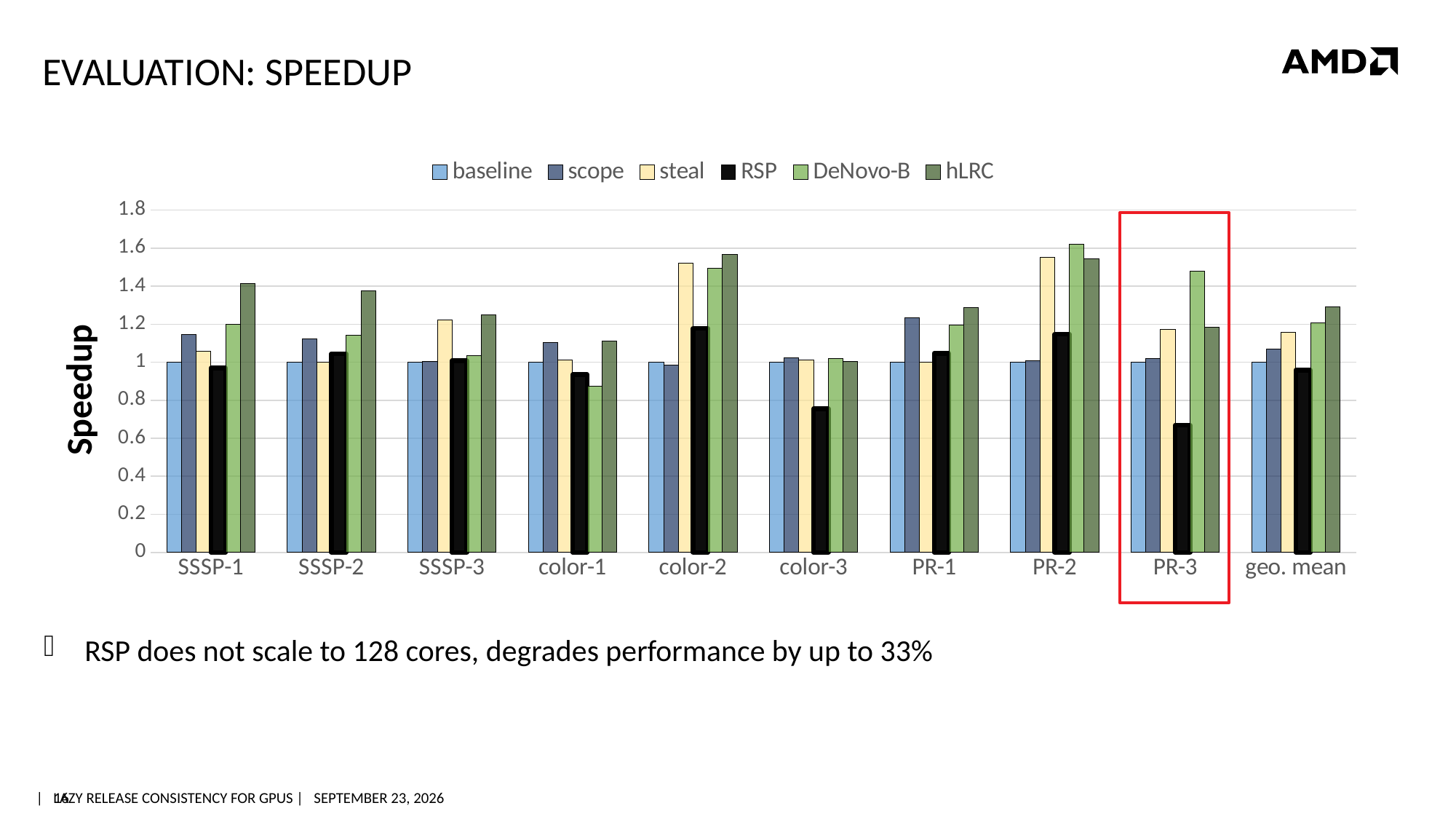
For color-1, which is larger: the hLRC value or the DeNovo-B value? hLRC Is the RSP value for PR-3 greater or less than 0.8? less Is the RSP value for color-3 greater or less than 0.8? less Is the hLRC value for color-2 greater or less than 1.4? greater How many series does the legend list? 6 For PR-3, which series has the highest speedup? DeNovo-B What is the speedup value of the baseline series for SSSP-1? 1 What is the title of the y axis? Speedup For PR-3, which series has the lowest speedup? RSP How many categories are shown along the x axis? 10 What kind of chart is shown on the slide? bar chart